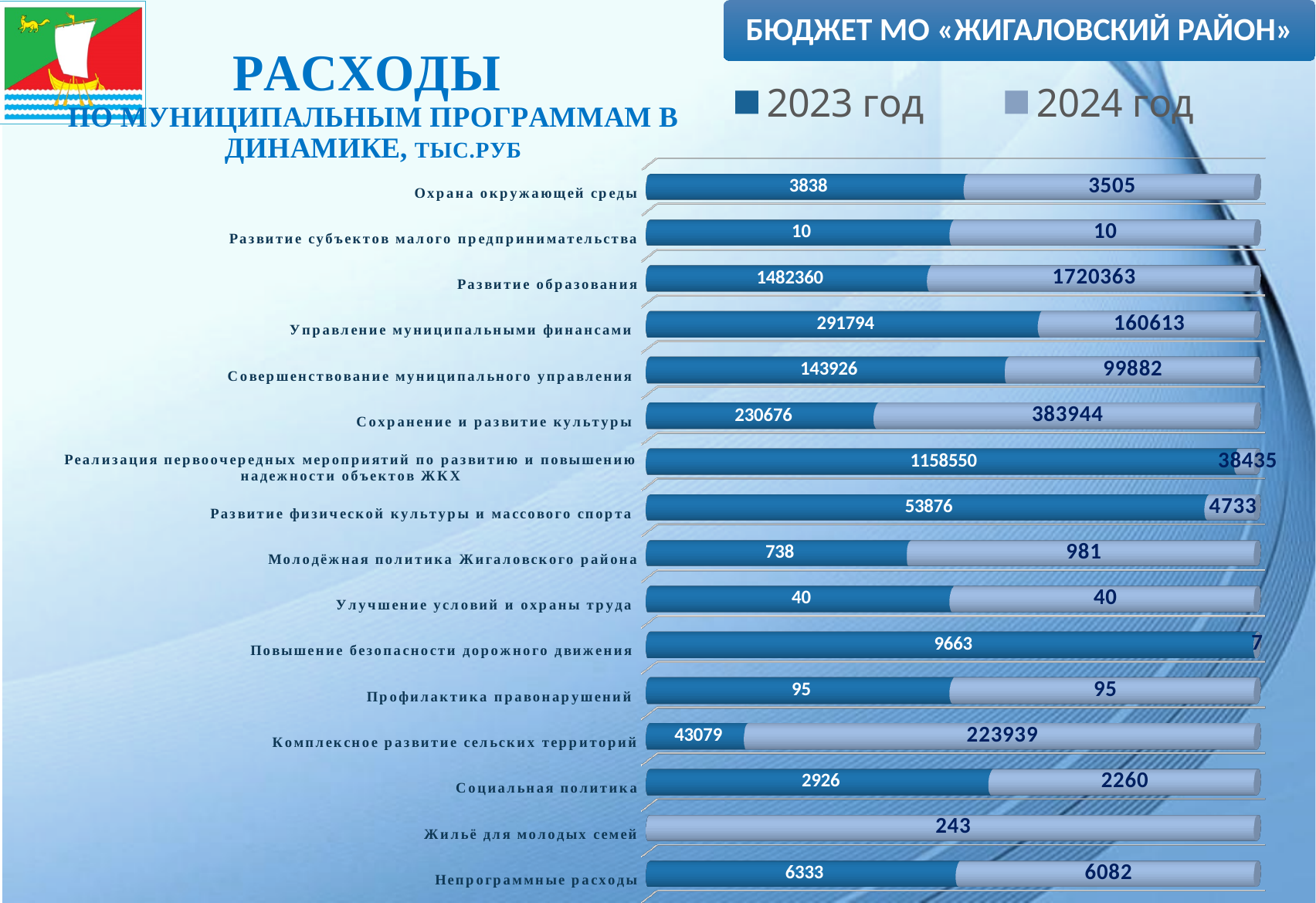
Which category has the lowest 2023 год value? Развитие субъектов малого предпринимательства What is the 2024 год value for Сохранение и развитие культуры? 383944 Which is larger for Социальная политика: the 2023 год value or the 2024 год value? 2023 год How many series does the legend list? 2 What is the 2023 год value for Развитие образования? 1482360 What is the difference between the 2024 год and 2023 год values for Развитие образования? 238003 What is the value shown for Жильё для молодых семей? 243 What is the 2023 год value for Управление муниципальными финансами? 291794 What kind of chart is shown on the slide? Bar chart Which category has the highest 2024 год value? Развитие образования How many categories are shown in the chart? 16 What is the 2024 год value for Комплексное развитие сельских территорий? 223939